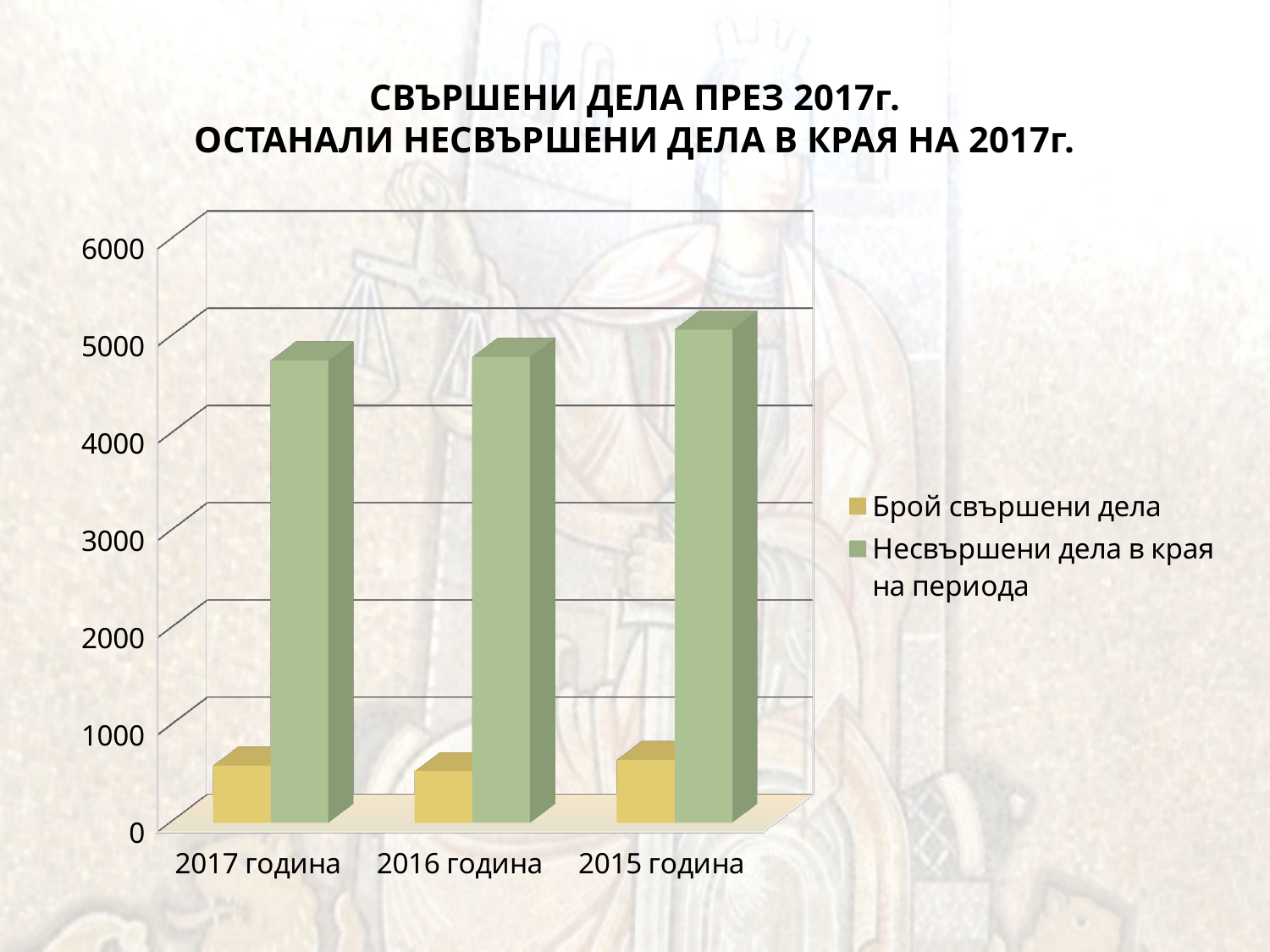
Is the value for Брой свършени дела in 2015 година greater or less than 1000? less Is the value for Брой свършени дела in 2017 година greater or less than 1000? less Is the value for Несвършени дела в края на периода in 2016 година greater or less than 4000? greater Which series is shown in green in the legend? Несвършени дела в края на периода Do the values for Несвършени дела в края на периода rise or fall moving left to right along the x axis from 2017 година to 2015 година? rise How many series does the legend list? 2 Which year has the highest value for Несвършени дела в края на периода? 2015 година Which is larger: Несвършени дела в края на периода in 2015 година or in 2017 година? 2015 година In each year, which series has the larger value: Брой свършени дела or Несвършени дела в края на периода? Несвършени дела в края на периода How many year categories are shown on the x axis? 3 What kind of chart is shown on the slide? bar chart